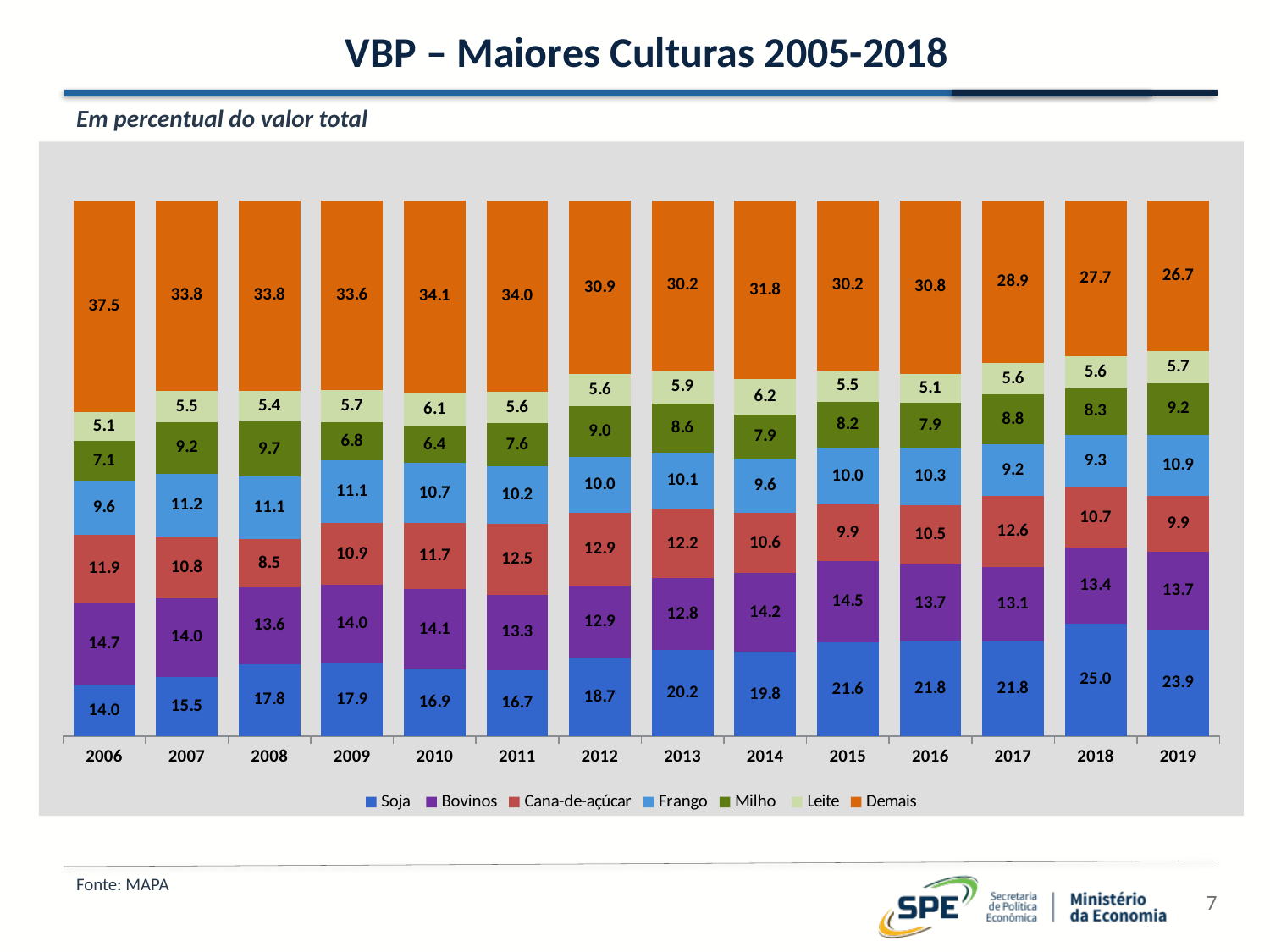
How many series does the legend list? 7 In which year is the Demais value lowest? 2019 What is the difference between the Soja value in 2019 and in 2006? 9.9 What kind of chart is shown on the slide? Stacked bar chart What is the value for Demais in 2006? 37.5 Which is larger in 2018, the Soja value or the Bovinos value? Soja How many years are shown along the x axis? 14 In which year is the Soja value highest? 2018 Does the Demais share generally rise or fall from 2006 to 2019? Fall What is the value for Soja in 2018? 25.0 What is the total of the stacked bar for 2019? 100.0 What is the value for Cana-de-açúcar in 2011? 12.5